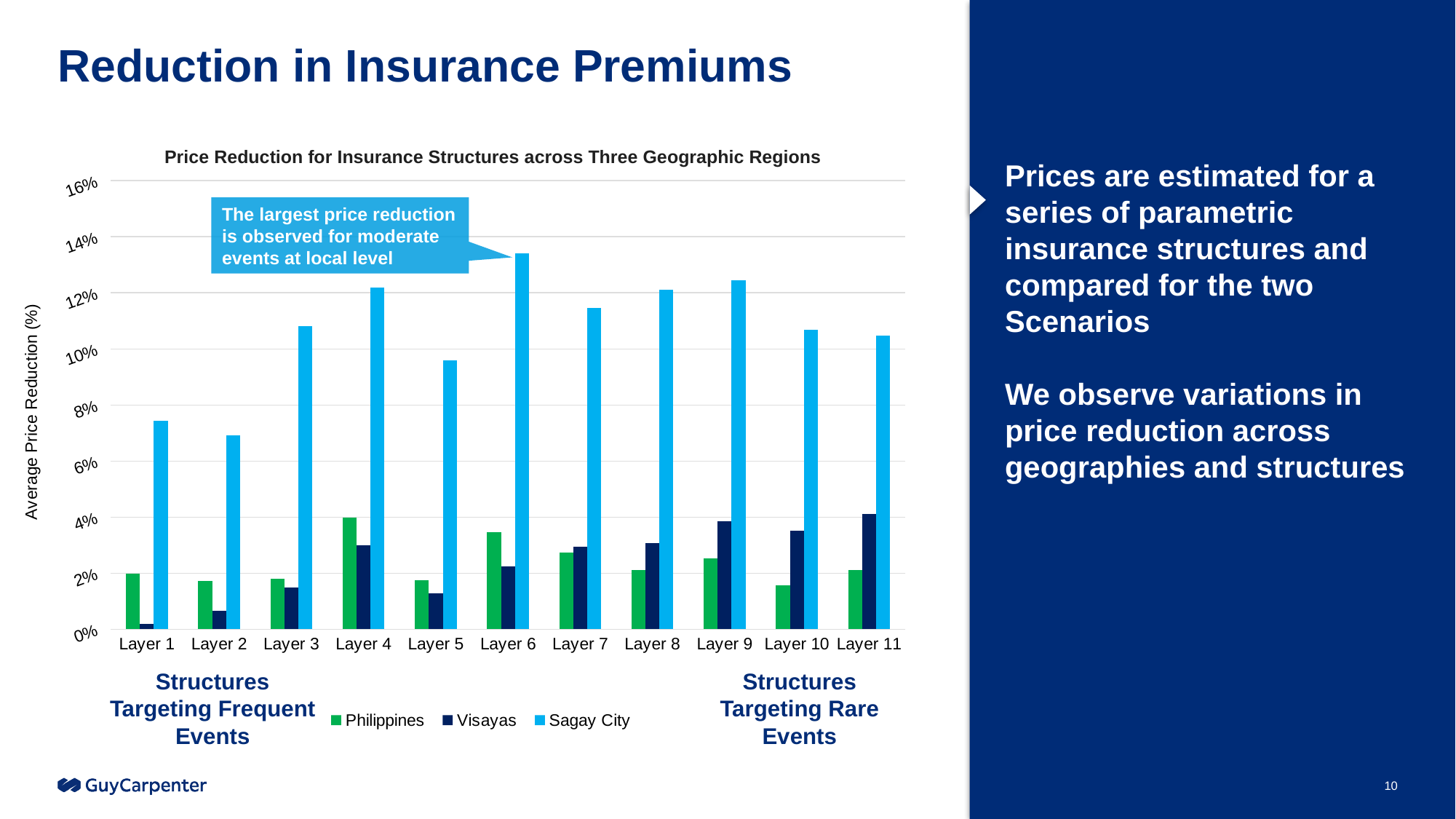
For Layer 11, which is larger: the Philippines value or the Visayas value? Visayas For which layer is the Sagay City price reduction highest? Layer 6 Is the Visayas value for Layer 1 greater or less than 2%? less For which layer is the Philippines price reduction highest? Layer 4 How many series does the legend list? 3 How many layers are shown on the x axis? 11 What kind of chart is shown on the slide? Bar chart What is the title of the chart? Price Reduction for Insurance Structures across Three Geographic Regions Is the Sagay City value for Layer 1 greater or less than 8%? less For which layer is the Visayas price reduction lowest? Layer 1 For Layer 1, which is larger: the Philippines value or the Visayas value? Philippines Is the Sagay City value for Layer 6 greater or less than 12%? greater